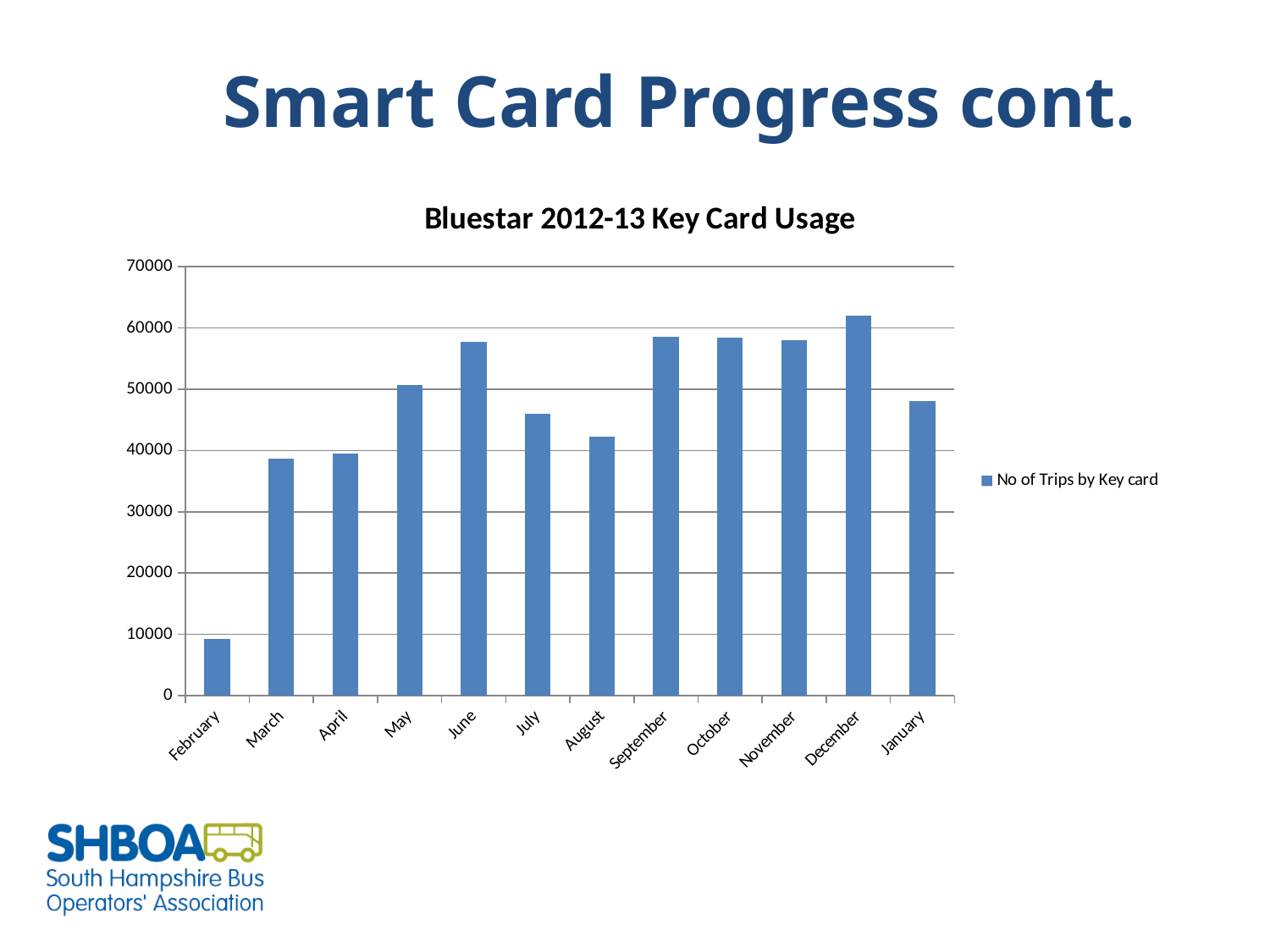
What kind of chart is shown on the slide? bar chart Which month has more trips by Key card, May or July? May Which month has the highest number of trips by Key card? December How many months are shown on the x axis? 12 Is the value for January greater or less than 50000? less What is the name of the series shown in the legend? No of Trips by Key card Is the value for February greater or less than 10000? less Is the value for December greater or less than 60000? greater Which month has the lowest number of trips by Key card? February What is the title of the chart? Bluestar 2012-13 Key Card Usage How many series does the legend list? 1 Do the values rise or fall from February to June? rise